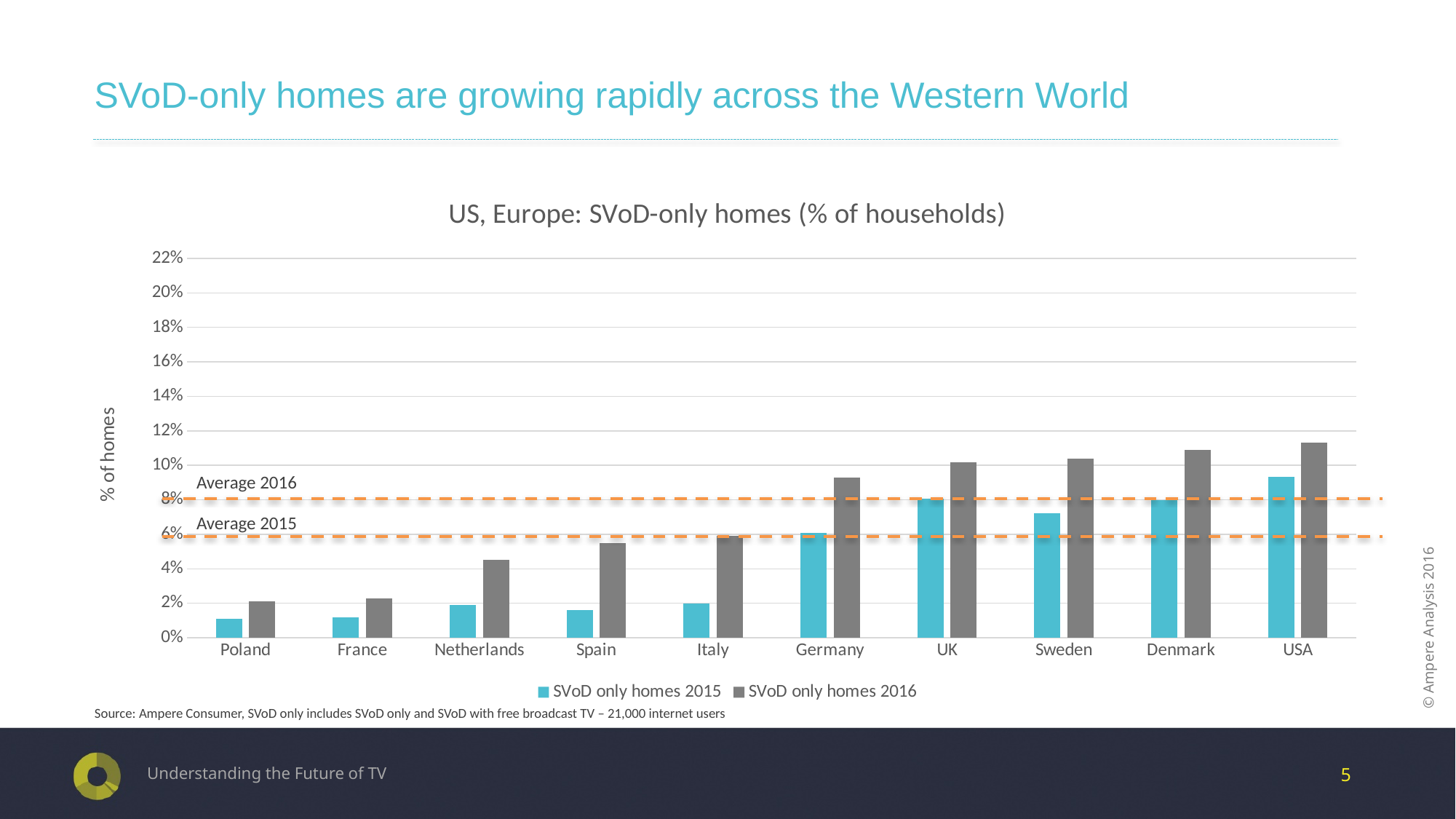
Which is larger: SVoD only homes 2016 in Germany or in the UK? UK Is the value for SVoD only homes 2016 in Denmark greater or less than 10%? greater Is the value for SVoD only homes 2016 in Spain greater or less than 6%? less How many countries are shown on the x axis of the chart? 10 How many series does the chart legend list? 2 Is the value for SVoD only homes 2016 in the USA greater or less than 10%? greater What kind of chart is shown on the slide? Bar chart Which is larger: SVoD only homes 2016 in the Netherlands or in Spain? Spain What is the title of the chart? US, Europe: SVoD-only homes (% of households) Which country has the highest value for SVoD only homes 2016? USA Which country has the highest value for SVoD only homes 2015? USA